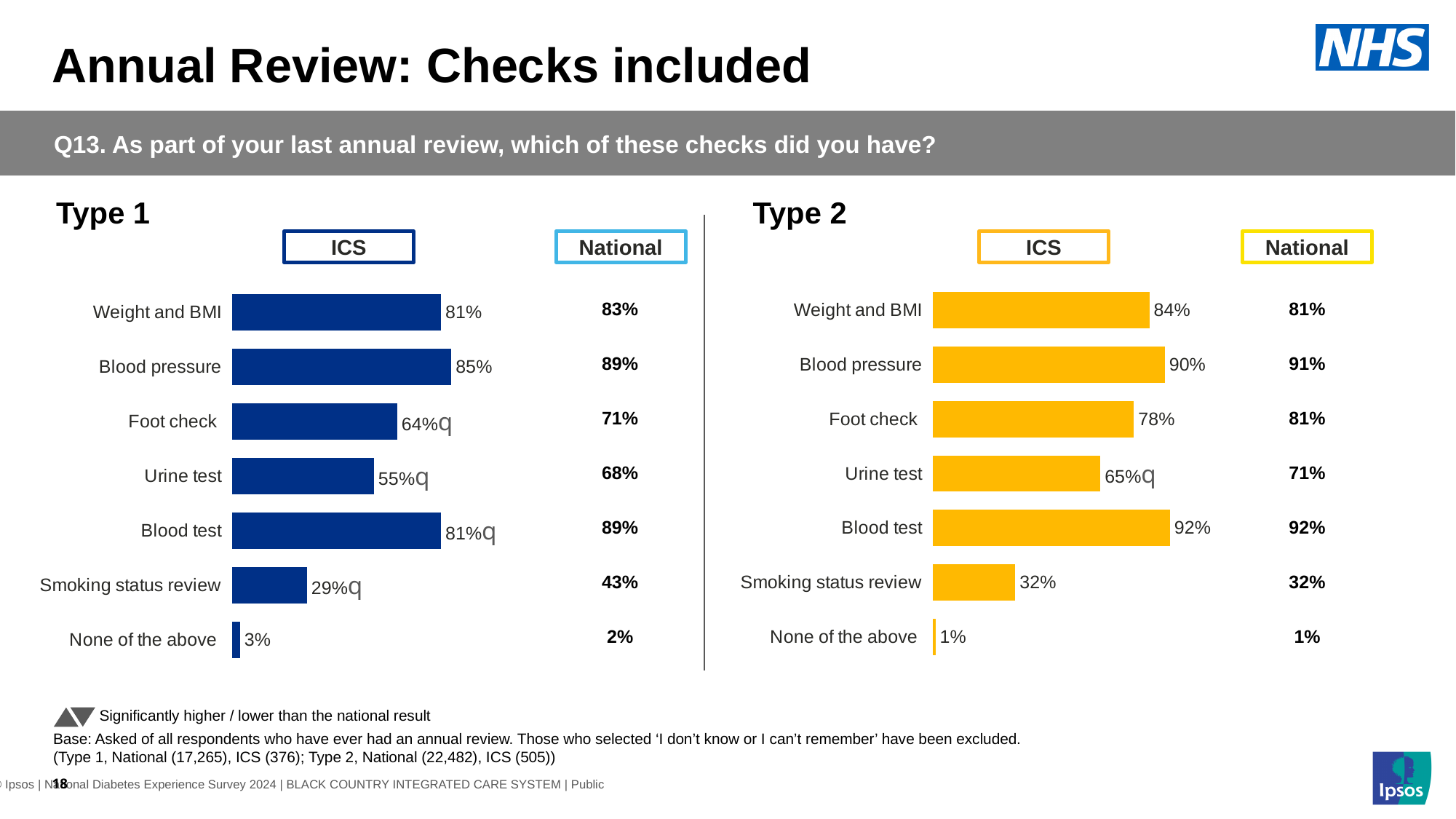
In the Type 2 chart, what is the National value for Urine test? 71% In the Type 1 chart, what is the difference between the National and ICS values for Urine test? 13 percentage points In the Type 1 chart, what is the ICS value for Blood pressure? 85% In the Type 2 chart, what is the difference between the ICS and National values for Weight and BMI? 3 percentage points In the Type 2 chart, what is the ICS value for Foot check? 78% In the Type 2 chart, which check has the highest ICS value? Blood test What colour are the ICS bars in the Type 2 chart? Yellow In the Type 1 chart, which check has the lowest ICS value? None of the above In the Type 1 chart, which is larger for Foot check: the ICS value or the National value? National How many checks are listed in the Type 2 chart? 7 What type of chart is used for the Type 1 ICS results? Bar chart In the Type 1 chart, what is the National value for Smoking status review? 43%